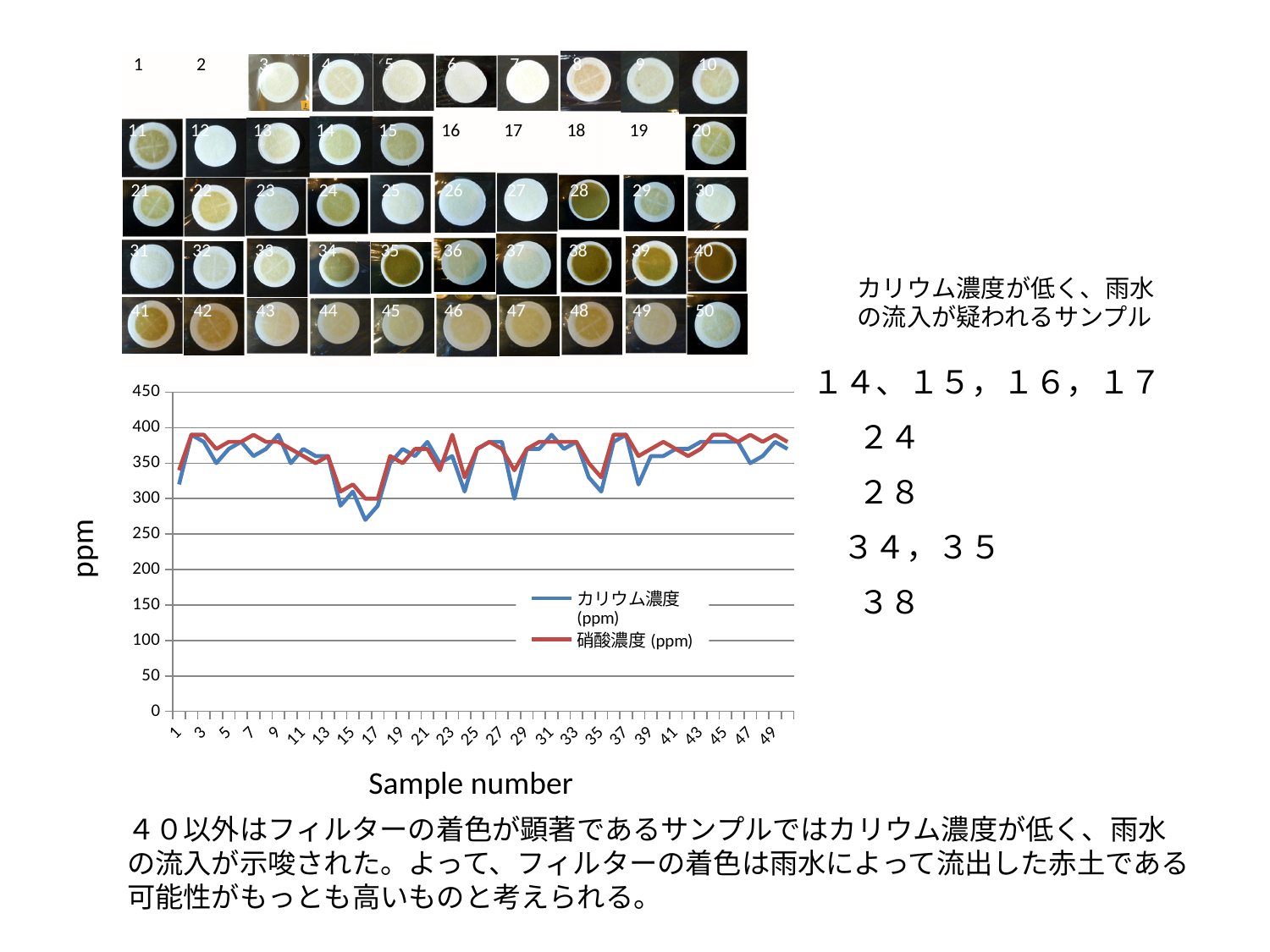
How many series does the chart's legend list? 2 Is the カリウム濃度 (ppm) value at sample 17 greater or less than 300? less What kind of chart is shown on the slide? line chart Is the カリウム濃度 (ppm) value at sample 35 greater or less than 350? less At sample 17, which series has the higher value, カリウム濃度 (ppm) or 硝酸濃度 (ppm)? 硝酸濃度 (ppm) What is the highest value shown on the y axis of the chart? 450 Is the カリウム濃度 (ppm) value at sample 2 greater or less than 350? greater At which sample number does the カリウム濃度 (ppm) series reach its lowest value? 16 What are the two series named in the chart's legend? カリウム濃度 (ppm) and 硝酸濃度 (ppm) What is the label on the x axis of the chart? Sample number